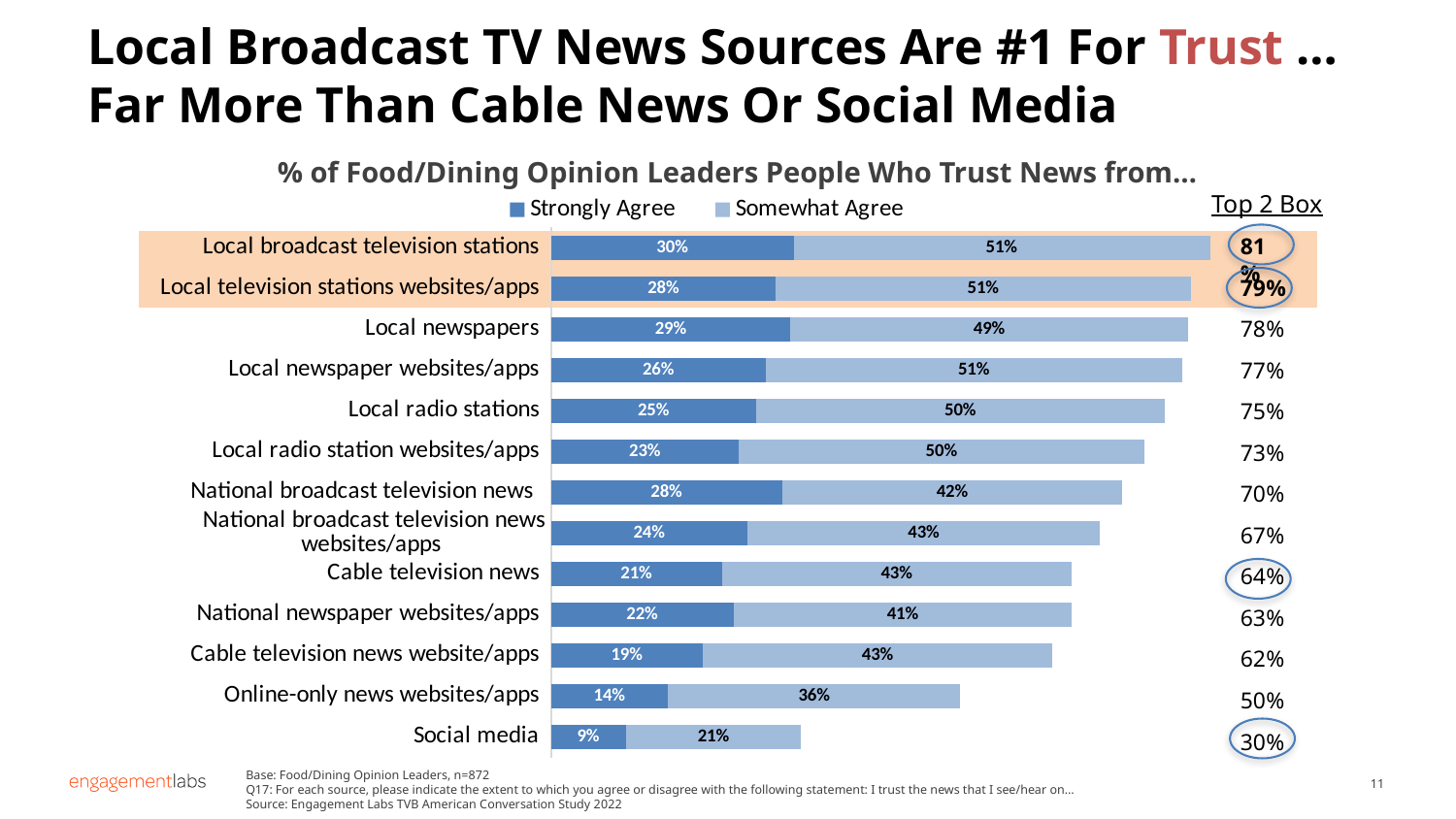
How many series does the legend list? 2 What is the Somewhat Agree value for Social media? 21% Which has a larger Strongly Agree value, National broadcast television news or Cable television news? National broadcast television news What is the Strongly Agree value for Local broadcast television stations? 30% Which news source has the highest Top 2 Box value? Local broadcast television stations Which news source has the lowest Strongly Agree value? Social media What are the two series named in the legend? Strongly Agree and Somewhat Agree What is the Top 2 Box value for Cable television news? 64% What is the difference between the Somewhat Agree values for Local newspapers and Social media? 28% What is the total of the stacked bar for Online-only news websites/apps? 50% How many news sources (categories) are plotted in the chart? 13 What kind of chart is shown on the slide? Stacked bar chart